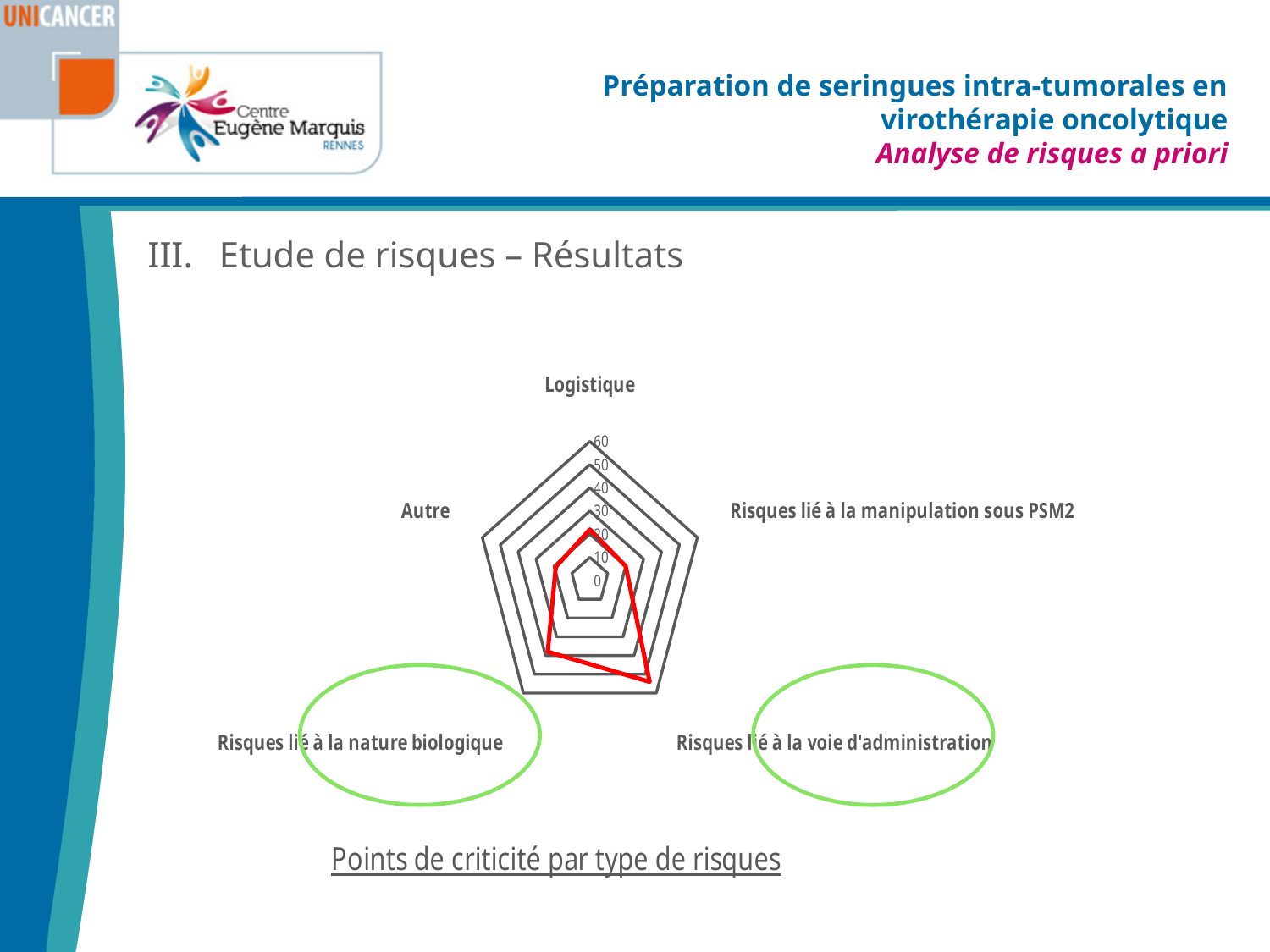
Is the value for Autre greater or less than 30? less What kind of chart is shown on the slide? Radar chart What is the maximum value shown on the radar chart's scale? 60 Which is larger, the value for Risques lié à la voie d'administration or the value for Autre? Risques lié à la voie d'administration Which category has the highest value on the radar chart? Risques lié à la voie d'administration Which is larger, the value for Risques lié à la nature biologique or the value for Logistique? Risques lié à la nature biologique What caption is written below the radar chart? Points de criticité par type de risques Is the value for Risques lié à la manipulation sous PSM2 greater or less than 40? less Is the value for Risques lié à la voie d'administration greater or less than 40? greater How many risk categories (axes) does the radar chart have? 5